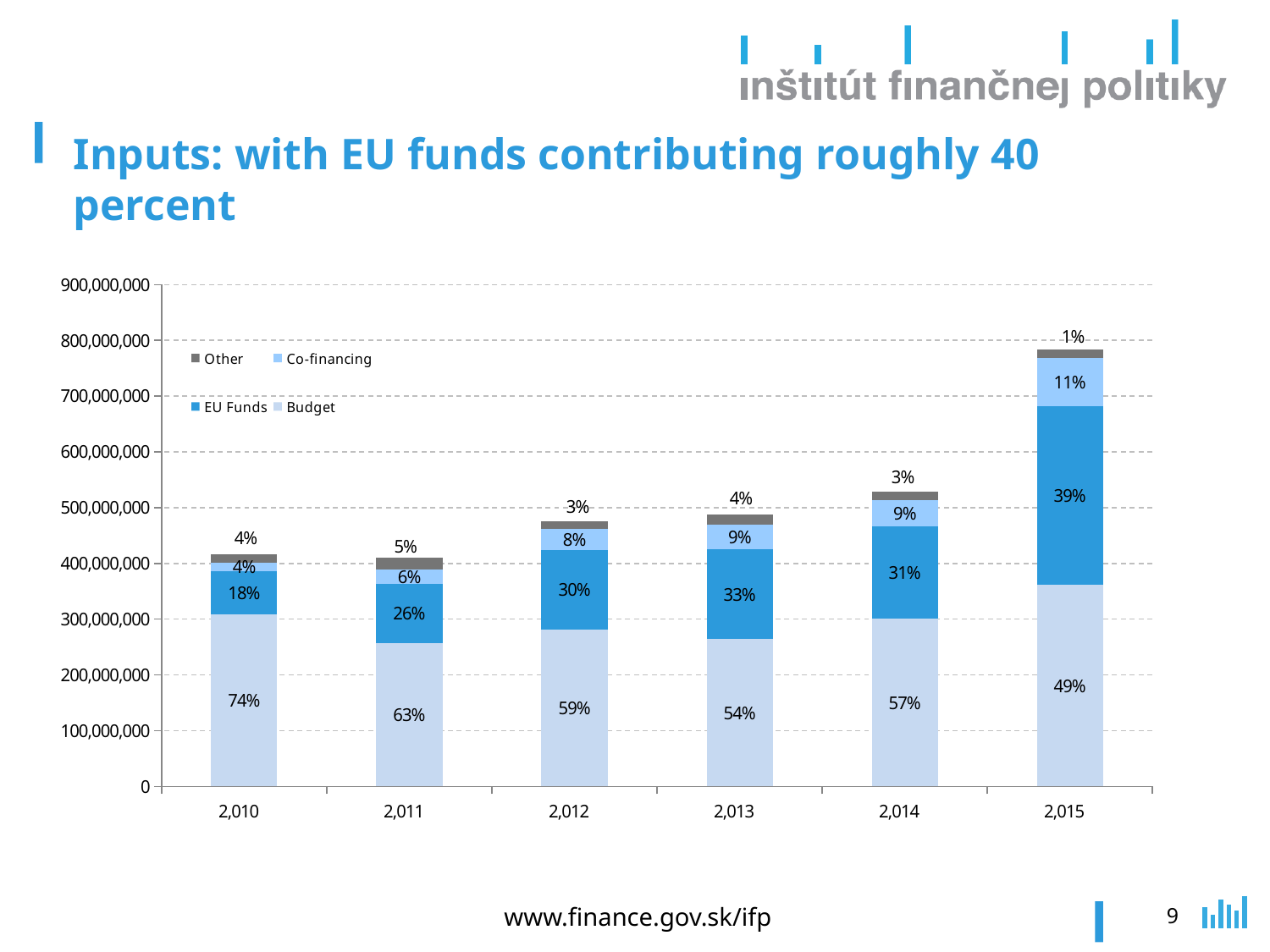
By how many percentage points does the EU Funds share in 2,015 exceed that in 2,010? 21 percentage points What is the EU Funds share labelled for 2,015? 39% How many series does the legend list? 4 What is the Budget share labelled for 2,010? 74% In which year is the EU Funds share the lowest? 2,010 Is the total value of the 2,013 bar greater or less than 500,000,000? less In which year is the Budget share the highest? 2,010 Which is larger, the Other share in 2,011 or the Other share in 2,015? 2,011 What is the Co-financing share labelled for 2,013? 9% How many years are shown on the x axis? 6 Is the total value of the 2,015 bar greater or less than 700,000,000? greater What kind of chart is shown on the slide? stacked bar chart